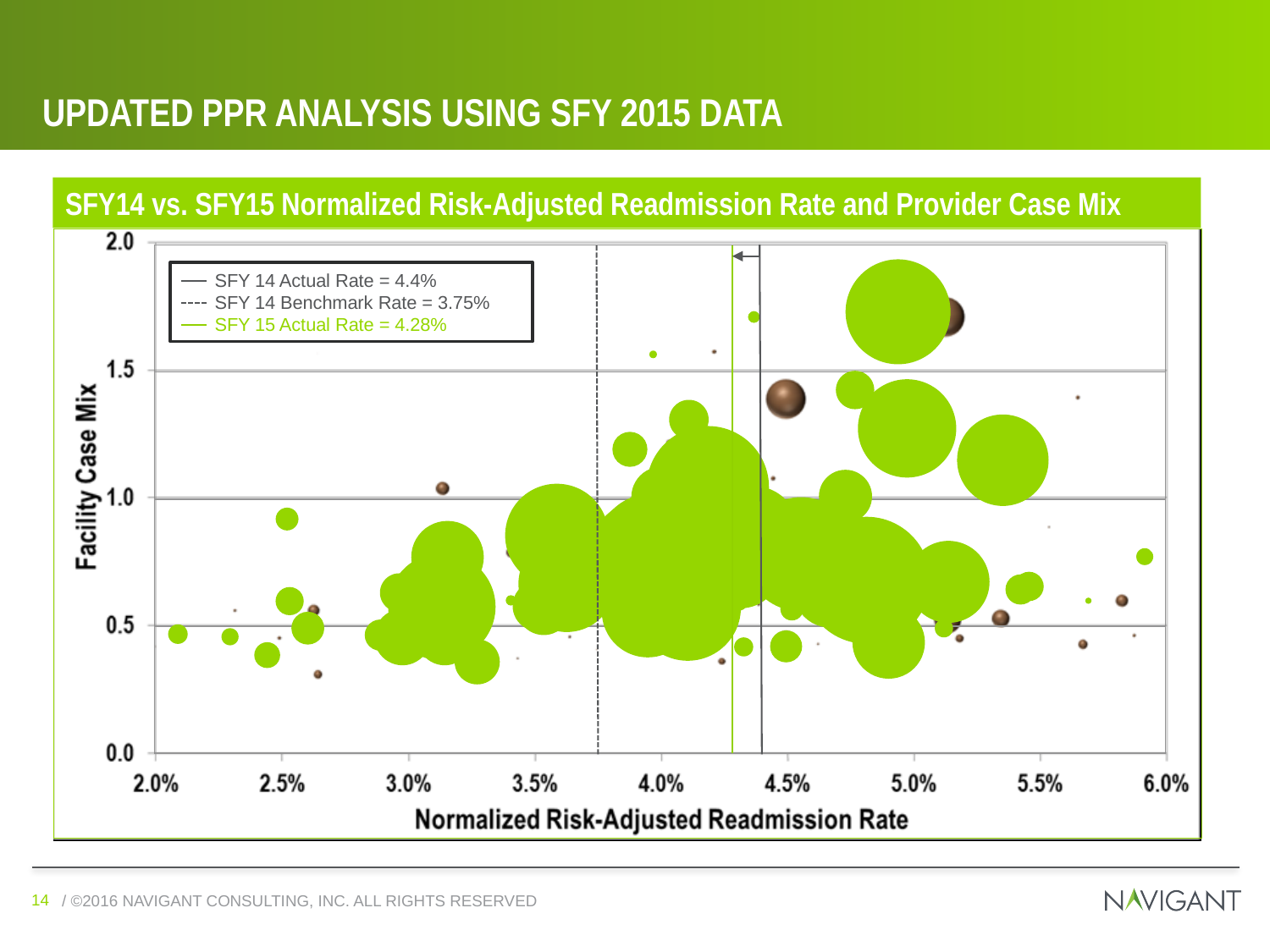
Which of the three rates listed in the legend is the lowest? SFY 14 Benchmark Rate (3.75%) What is the SFY 14 Benchmark Rate shown in the legend? 3.75% What is the difference between the SFY 14 Actual Rate and the SFY 14 Benchmark Rate? 0.65 percentage points Which of the three rates listed in the legend is the highest? SFY 14 Actual Rate (4.4%) What is the title of the x axis? Normalized Risk-Adjusted Readmission Rate What is the SFY 14 Actual Rate shown in the legend? 4.4% What kind of chart is shown on the slide? Bubble chart Which is larger, the SFY 14 Actual Rate or the SFY 15 Actual Rate? SFY 14 Actual Rate How many entries does the legend list? 3 What is the difference between the SFY 14 Actual Rate and the SFY 15 Actual Rate? 0.12 percentage points What is the SFY 15 Actual Rate shown in the legend? 4.28% Is the SFY 14 Benchmark Rate greater or less than 4.0%? less